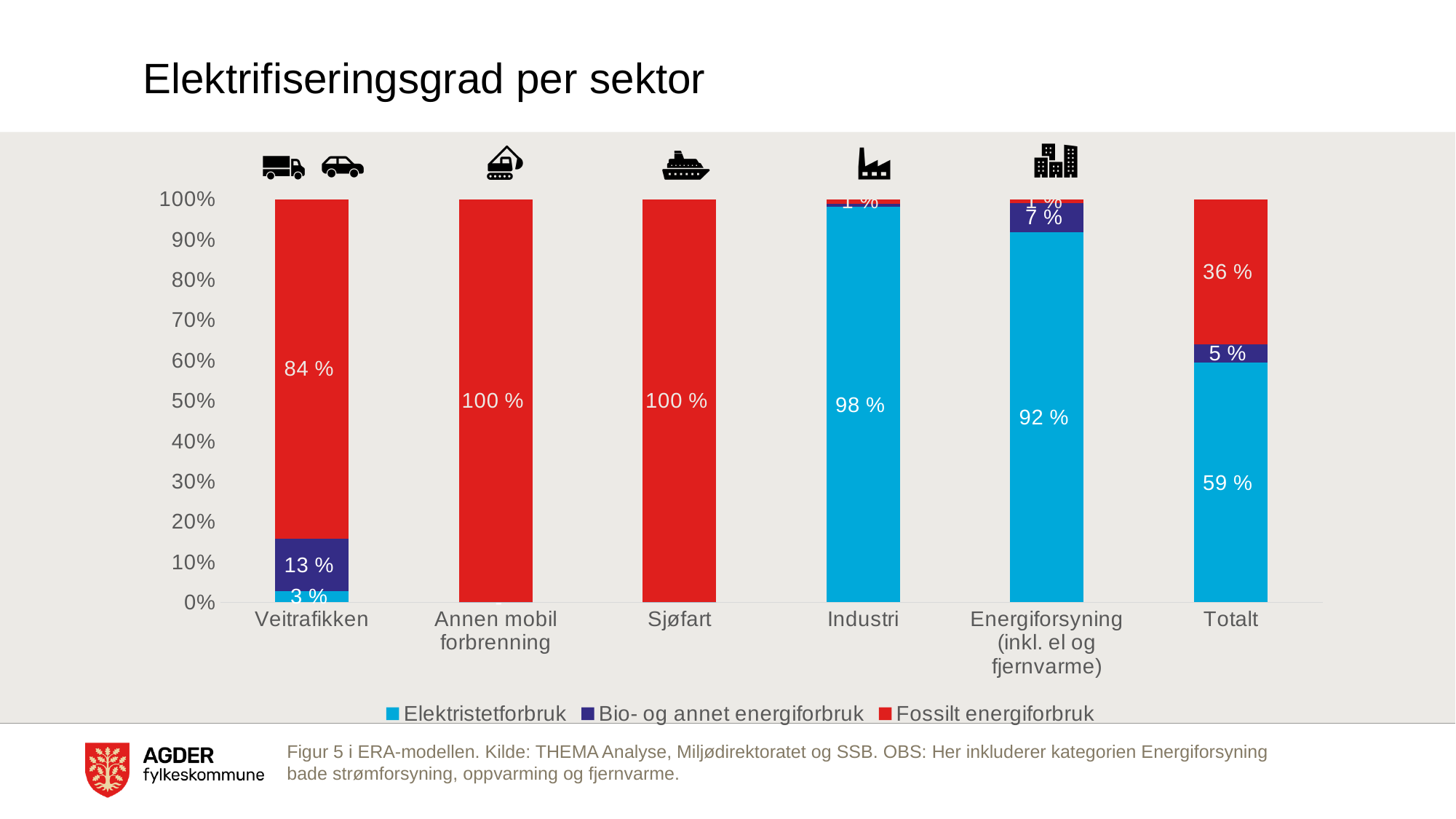
What is the difference between the Fossilt energiforbruk share for Veitrafikken and for Totalt? 48 % How many series does the legend list? 3 How many sectors (categories) are shown on the x axis? 6 What is the Elektristetforbruk share for Totalt? 59 % Which sector has the lowest Elektristetforbruk share among those with a labelled electricity value? Veitrafikken What is the title of the chart? Elektrifiseringsgrad per sektor What is the Fossilt energiforbruk share for Veitrafikken? 84 % What is the Fossilt energiforbruk share for Sjøfart? 100 % What type of chart is shown on the slide? Stacked bar chart What is the Elektristetforbruk share for Industri? 98 % Is the Elektristetforbruk share for Energiforsyning (inkl. el og fjernvarme) larger or smaller than that for Totalt? Larger What is the Bio- og annet energiforbruk share for Energiforsyning (inkl. el og fjernvarme)? 7 %